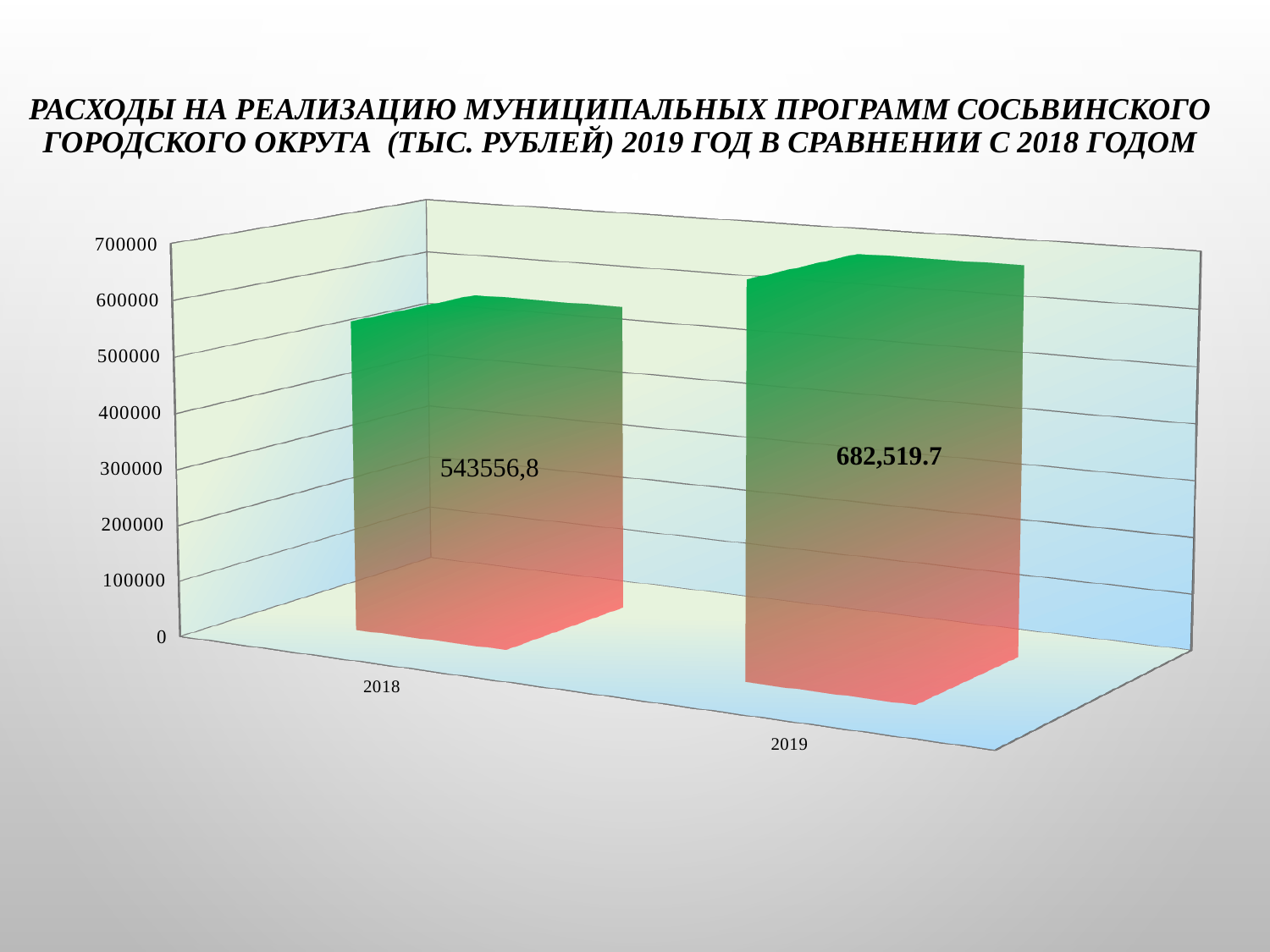
What is the highest value marked on the vertical axis? 700000 Is the value for 2019 greater or less than 700000? less What kind of chart is shown on the slide? bar chart Is the value for 2018 greater or less than 500000? greater In what unit are the expenses given according to the chart title? тыс. рублей Do the values rise or fall from 2018 to 2019? rise What is the value shown for 2019? 682,519.7 Is the value for 2019 larger or smaller than the value for 2018? larger How many bars are plotted on the chart? 2 What is the value shown for 2018? 543556,8 Which year has the higher value? 2019 Which year has the lower value? 2018